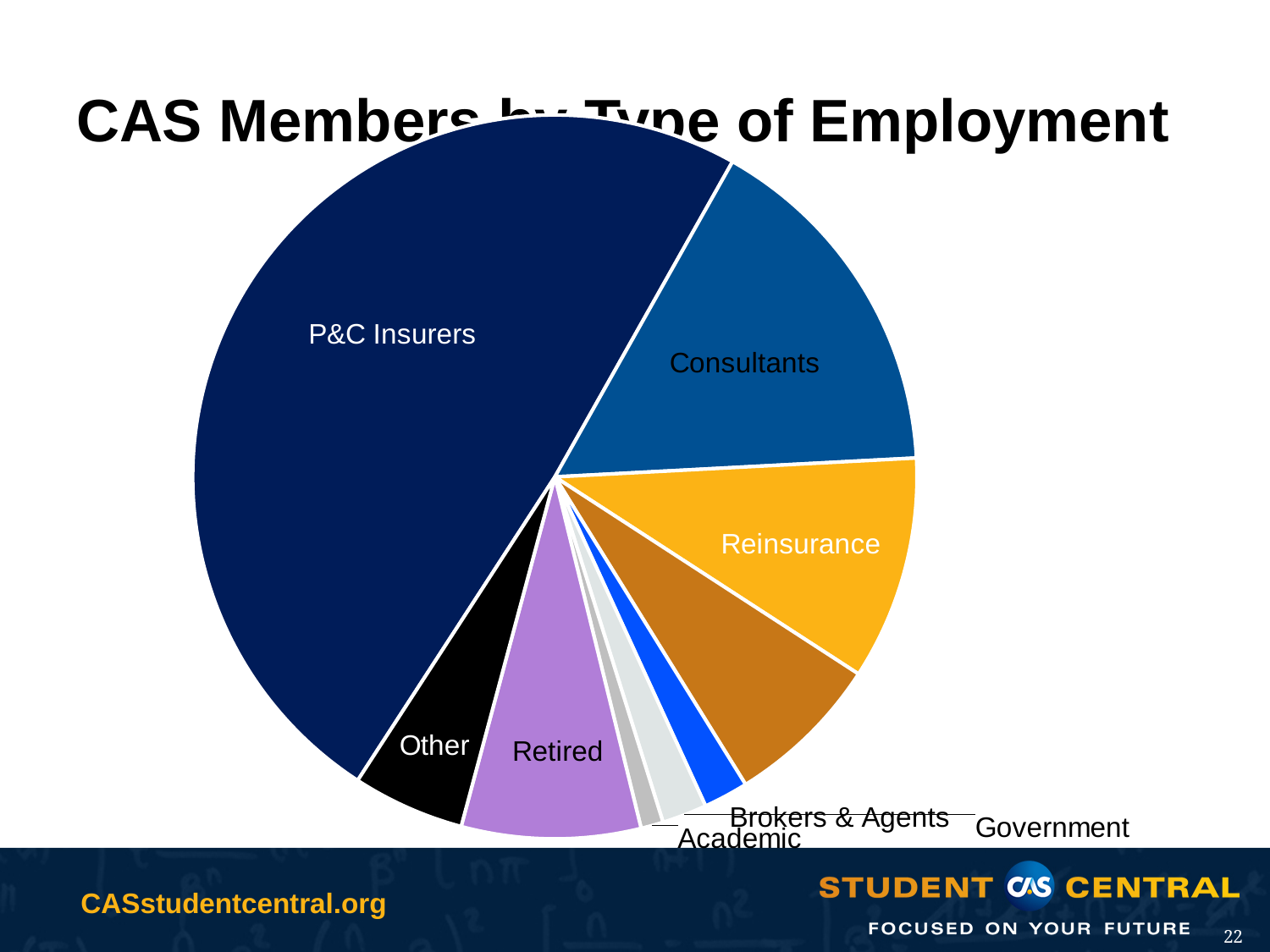
Which slice is larger, Reinsurance or Retired? Reinsurance Which slice is larger, Retired or Other? Retired Which slice is larger, Government or Retired? Retired What kind of chart is shown on the slide? pie chart What colour is the Reinsurance slice? yellow/gold What colour is the P&C Insurers slice? dark navy blue Does the Consultants slice account for more or less than a quarter of the pie? less Which type of employment has the largest slice of the pie? P&C Insurers